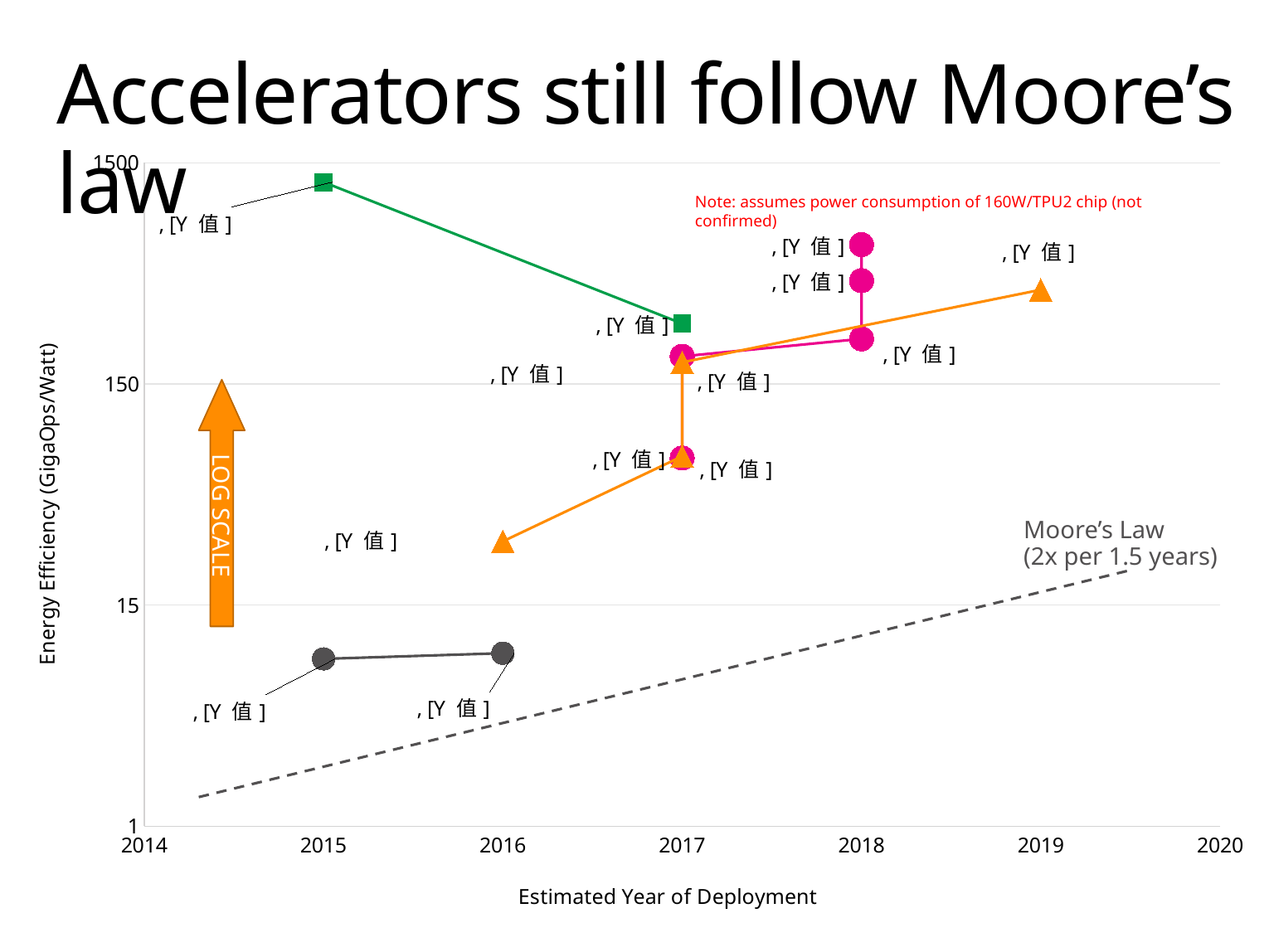
Is the value of the orange triangle point at 2019 greater or less than 150? greater Is the value of the gray circle point at 2015 greater or less than 15? less Which is larger: the green square point at 2015 or the green square point at 2017? 2015 Is the value of the green square point at 2015 greater or less than 150? greater What is the title of the x axis? Estimated Year of Deployment How many year tick labels are shown on the x axis? 7 Do the green square points rise or fall from 2015 to 2017? fall What kind of chart is shown on the slide? Scatter chart with lines What is the title of the y axis? Energy Efficiency (GigaOps/Watt) Which is larger: the orange triangle point at 2016 or the orange triangle point at 2019? 2019